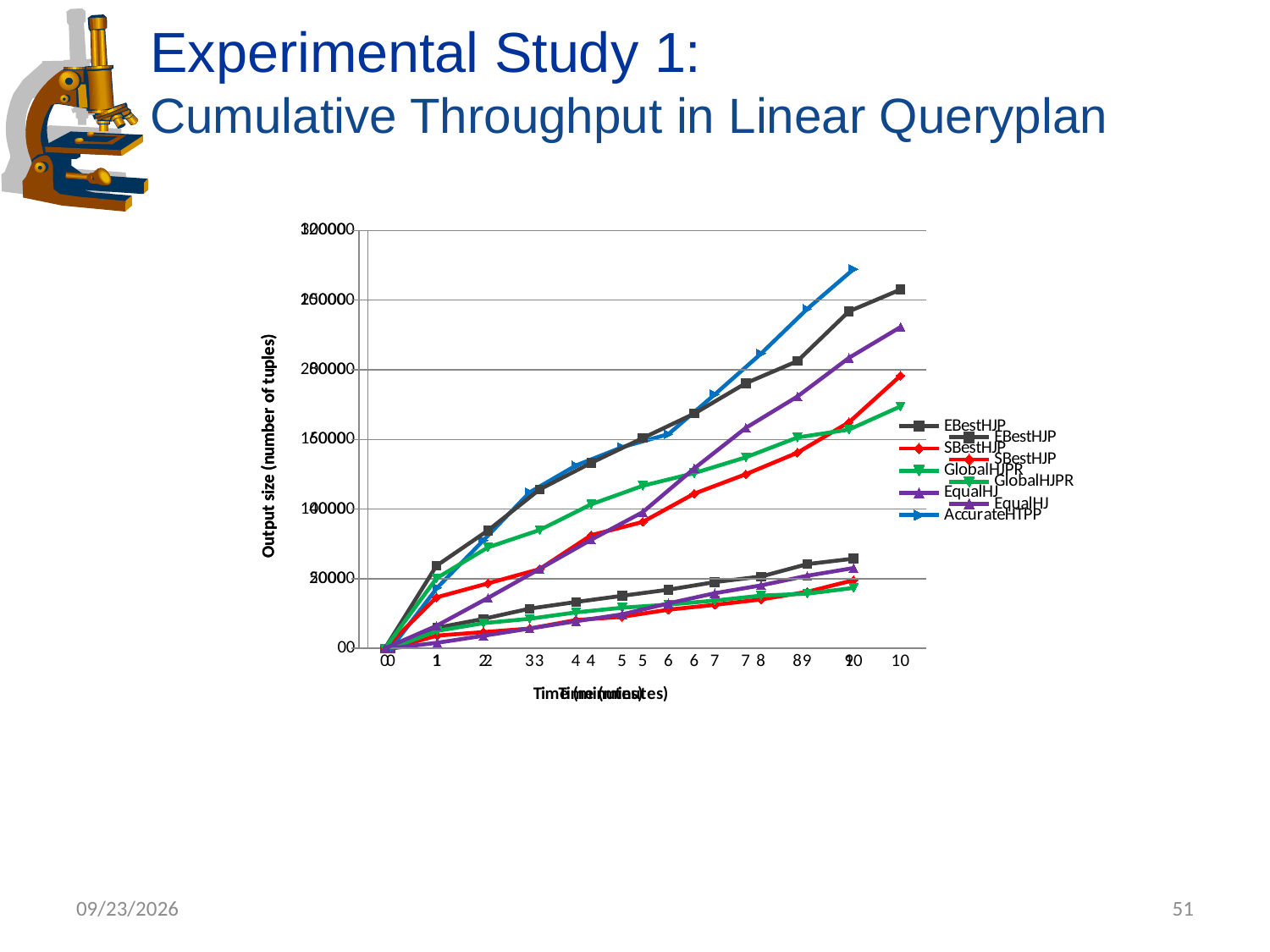
What is the label of the vertical axis of the chart? Output size (number of tuples) Which series is drawn in red in the chart? SBestHJP Which series is drawn in blue in the chart legend? AccurateHTPP In the upper set of lines, which series reaches the highest value at the end of the time axis? AccurateHTPP Do the plotted values rise or fall as time increases along the x axis? rise At the end of the time axis, which of the upper lines is higher: SBestHJP or GlobalHJPR? SBestHJP What kind of chart is shown on the slide? line chart In the upper set of lines, which series has the lowest value at the end of the time axis? GlobalHJPR At the end of the time axis, which of the upper lines is higher: EBestHJP or EqualHJ? EBestHJP